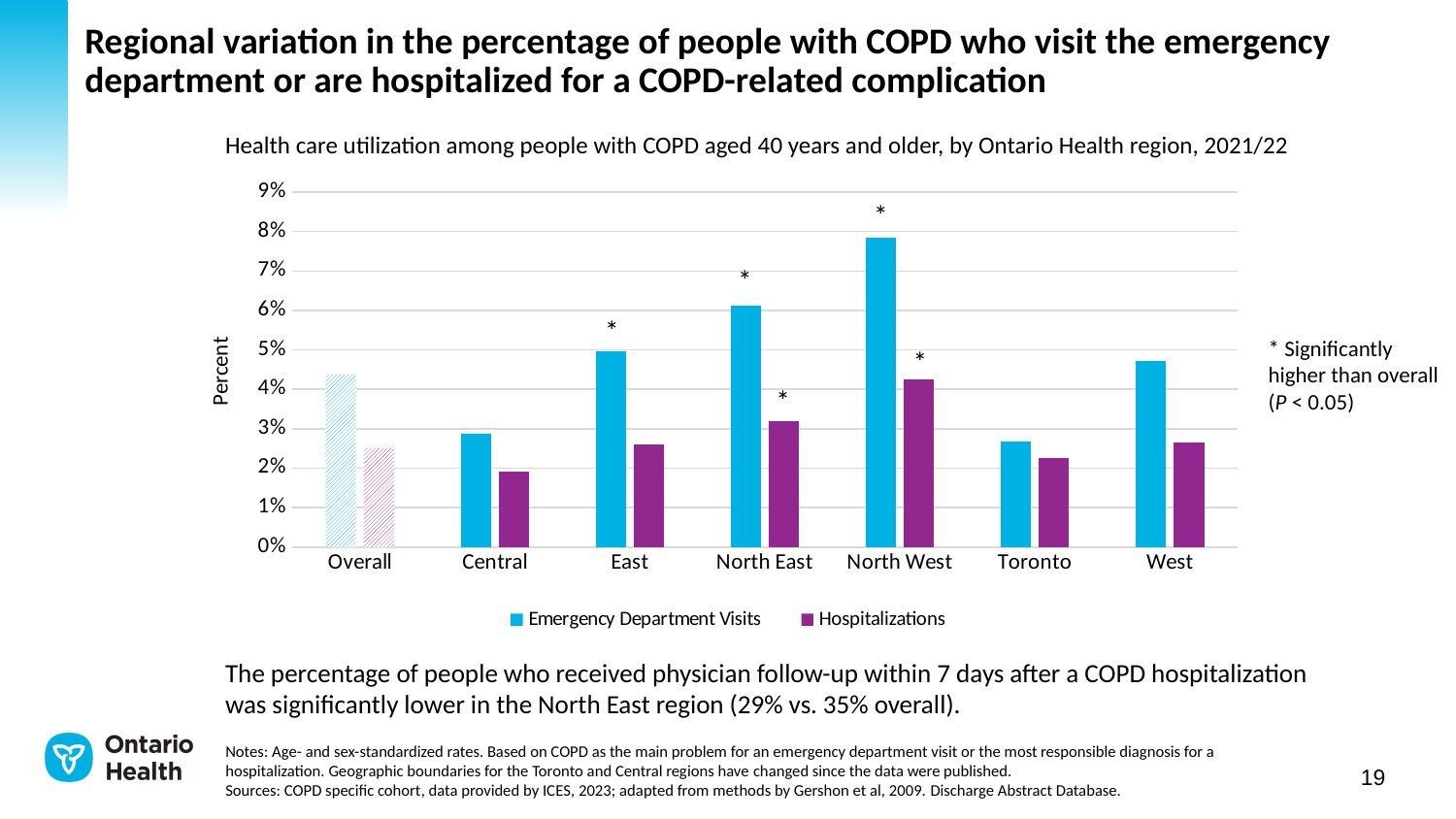
Is the Emergency Department Visits value for Toronto greater or less than 3%? less Which region has the highest value for Hospitalizations? North West Which region has the lowest value for Hospitalizations? Central How many regions (categories) are shown on the x axis, including Overall? 7 Which is larger: the Emergency Department Visits value for North East or for West? North East How many series does the legend list? 2 Which region has the highest value for Emergency Department Visits? North West What does the asterisk above some bars indicate, according to the chart note? Significantly higher than overall (P < 0.05) Is the Emergency Department Visits value for North West greater or less than 7%? greater Which is larger: the Hospitalizations value for East or the Emergency Department Visits value for East? Emergency Department Visits What kind of chart is shown on the slide? Bar chart Is the Hospitalizations value for North West greater or less than 3%? greater